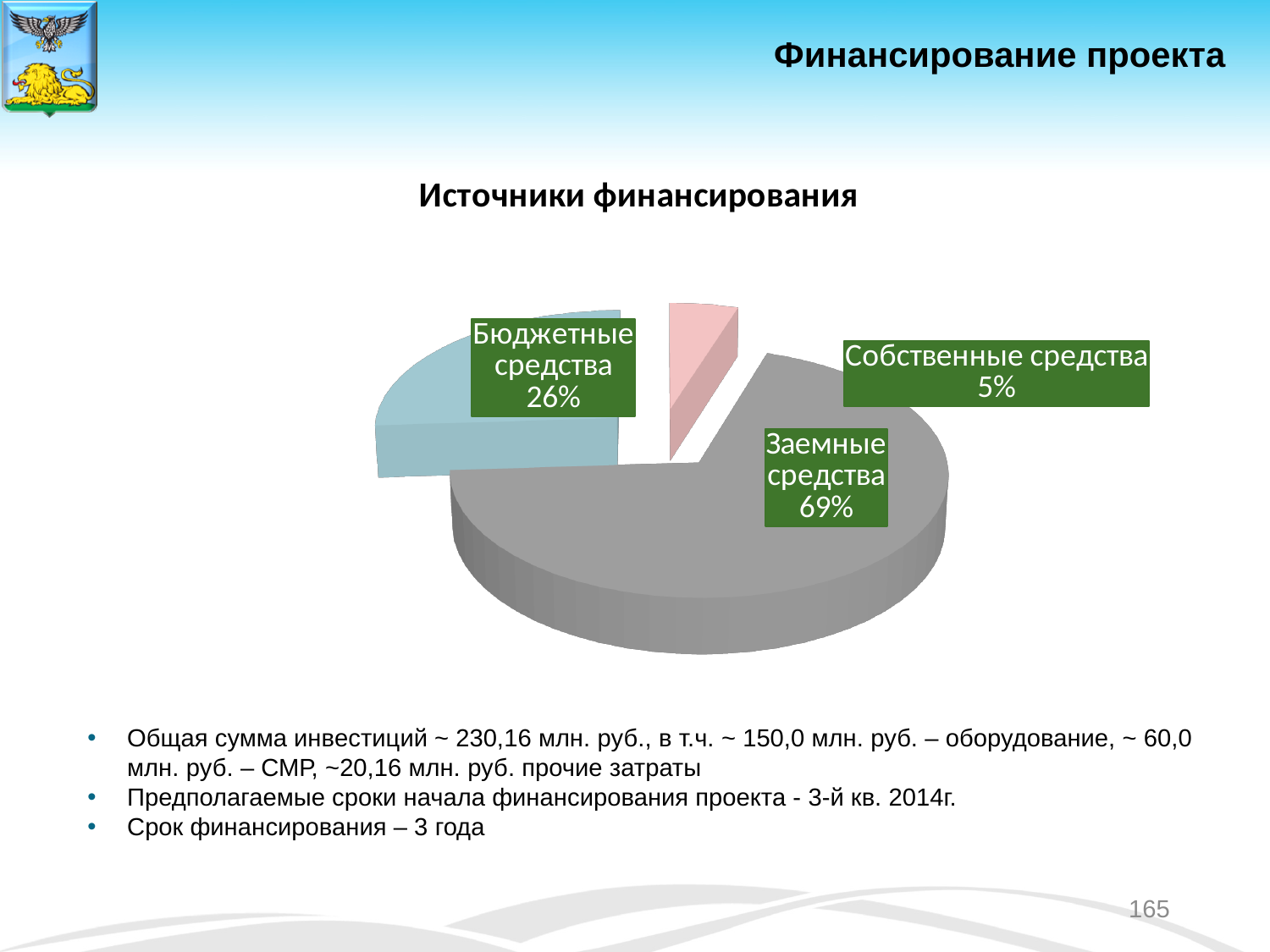
What is the difference in percentage points between Бюджетные средства and Собственные средства? 21 What colour is the slice for Заемные средства? Grey What is the difference in percentage points between Заемные средства and Бюджетные средства? 43 What share of the pie is Бюджетные средства? 26% Which source of financing has the smallest share? Собственные средства Which source of financing has the largest share? Заемные средства What share of the pie is Собственные средства? 5% What is the title of the chart? Источники финансирования Which is larger: the share of Бюджетные средства or Собственные средства? Бюджетные средства What type of chart is shown on the slide? Pie chart How many slices does the pie chart have? 3 What share of the pie is Заемные средства? 69%